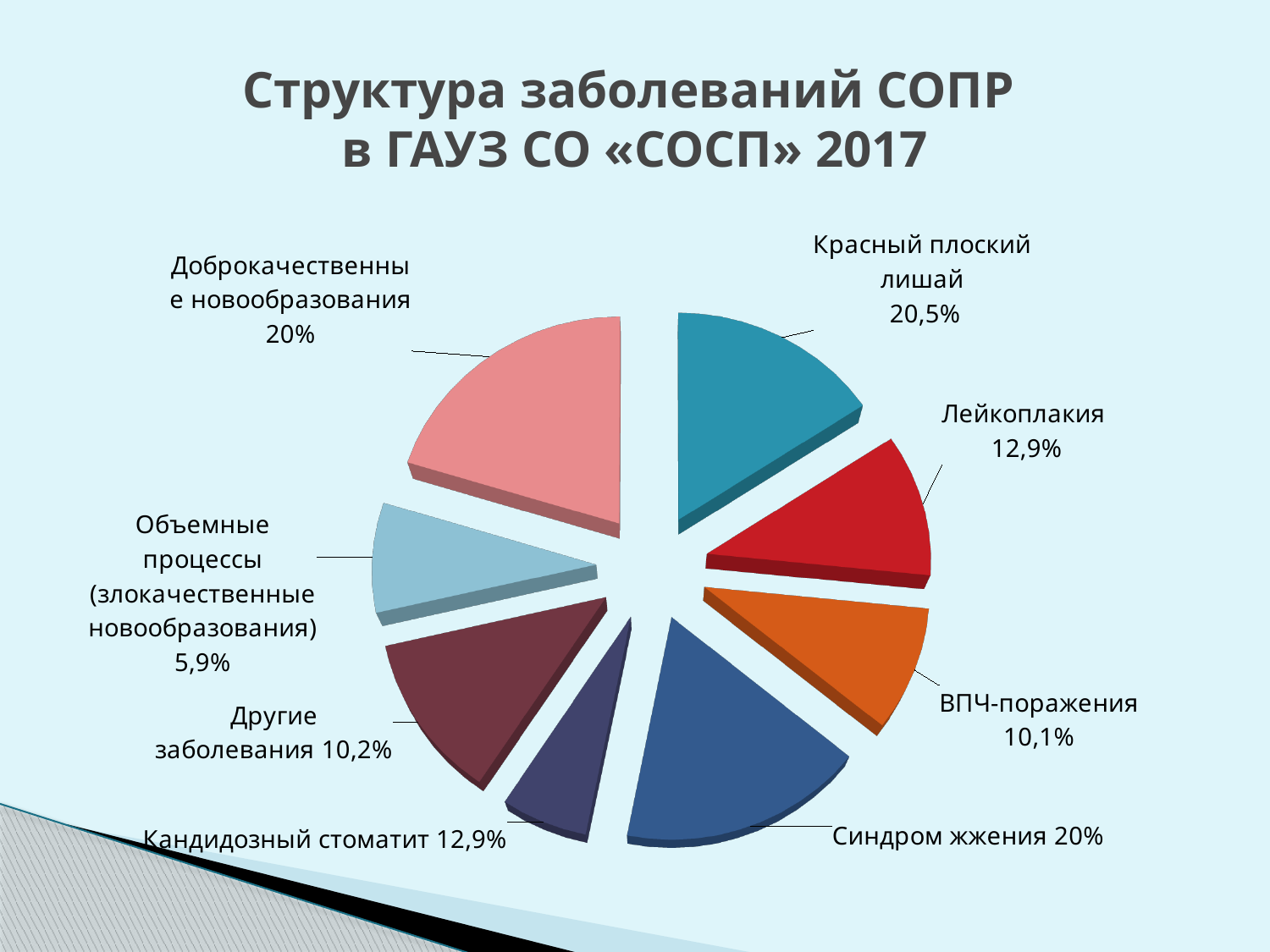
What kind of chart is shown on the slide? pie chart What is the share for Красный плоский лишай? 20,5% How many slices does the pie chart have? 8 Which category has the largest share of the pie? Красный плоский лишай Which category has the smallest share of the pie? Объемные процессы (злокачественные новообразования) What is the share for Объемные процессы (злокачественные новообразования)? 5,9% What is the difference between the shares of Красный плоский лишай and Лейкоплакия? 7,6% What is the share for Лейкоплакия? 12,9% What is the share for Другие заболевания? 10,2% Which is larger, the share for Синдром жжения or the share for Кандидозный стоматит? Синдром жжения What is the title of the chart on the slide? Структура заболеваний СОПР в ГАУЗ СО «СОСП» 2017 What is the share for ВПЧ-поражения? 10,1%